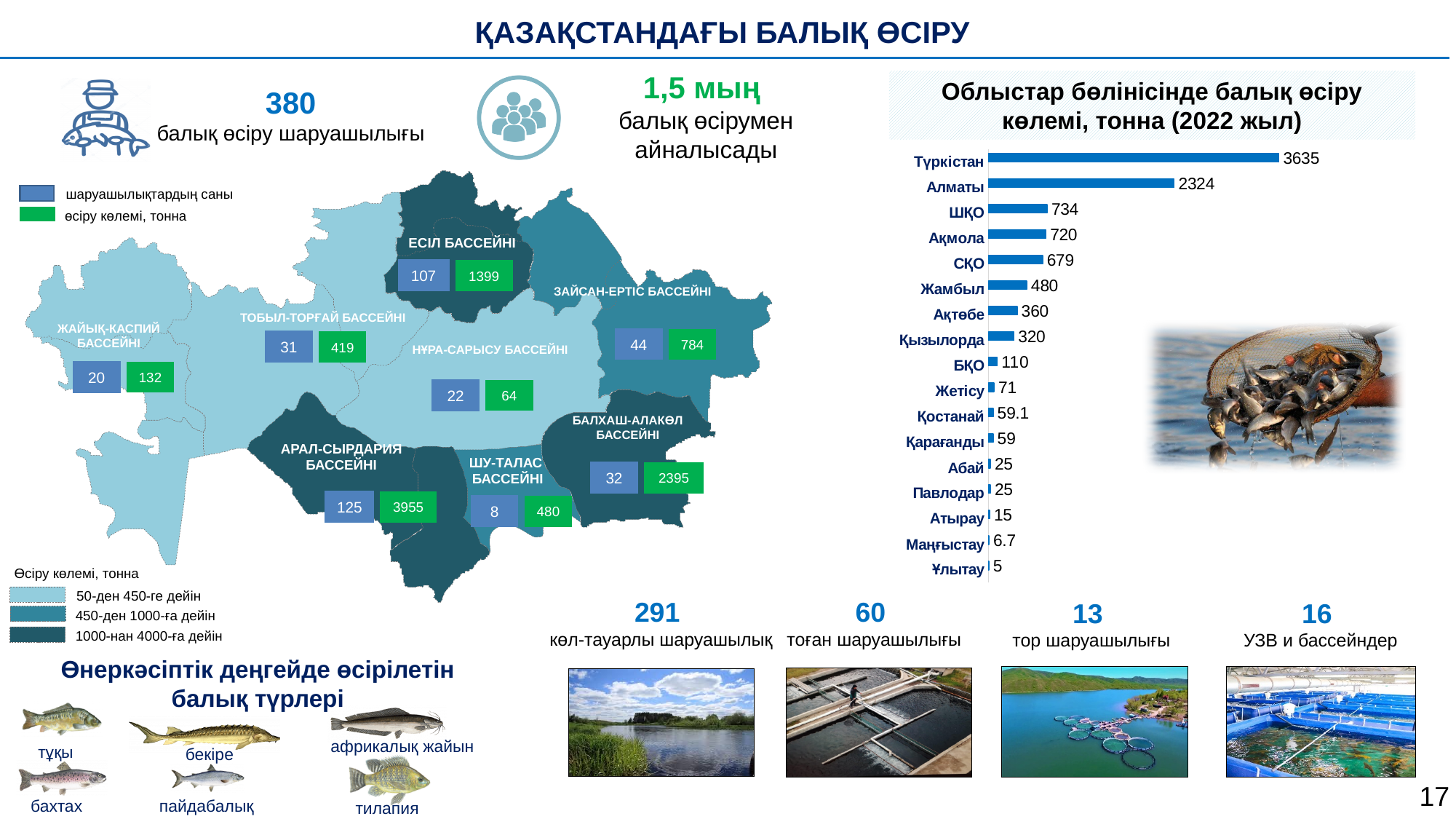
In the chart 'Облыстар бөлінісінде балық өсіру көлемі, тонна (2022 жыл)', which region has the lowest value? Ұлытау In the chart 'Облыстар бөлінісінде балық өсіру көлемі, тонна (2022 жыл)', which is larger, the value for БҚО or the value for Қызылорда? Қызылорда In the chart 'Облыстар бөлінісінде балық өсіру көлемі, тонна (2022 жыл)', what is the value for Маңғыстау? 6.7 In the chart 'Облыстар бөлінісінде балық өсіру көлемі, тонна (2022 жыл)', which region has the highest value? Түркістан In the chart 'Облыстар бөлінісінде балық өсіру көлемі, тонна (2022 жыл)', which is larger, the value for Жамбыл or the value for Ақтөбе? Жамбыл What kind of chart is 'Облыстар бөлінісінде балық өсіру көлемі, тонна (2022 жыл)'? Bar chart How many regions are shown in the chart 'Облыстар бөлінісінде балық өсіру көлемі, тонна (2022 жыл)'? 17 In the chart 'Облыстар бөлінісінде балық өсіру көлемі, тонна (2022 жыл)', what is the value for Түркістан? 3635 In the chart 'Облыстар бөлінісінде балық өсіру көлемі, тонна (2022 жыл)', what is the value for Қостанай? 59.1 In the chart 'Облыстар бөлінісінде балық өсіру көлемі, тонна (2022 жыл)', what is the difference between the values for Түркістан and Алматы? 1311 In the chart 'Облыстар бөлінісінде балық өсіру көлемі, тонна (2022 жыл)', what is the value for Ақмола? 720 In the chart 'Облыстар бөлінісінде балық өсіру көлемі, тонна (2022 жыл)', what is the difference between the values for ШҚО and СҚО? 55